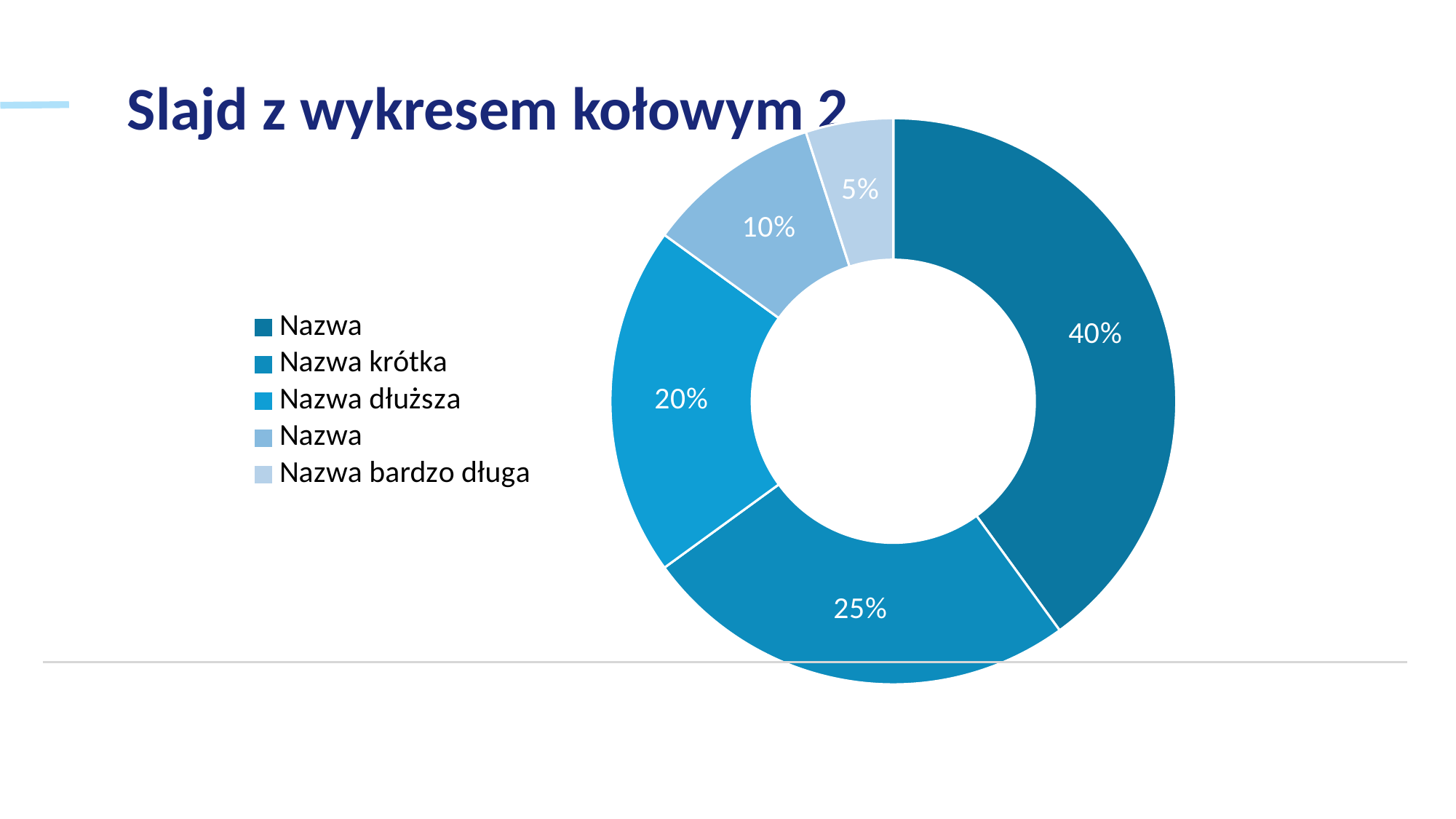
What share of the doughnut chart does the slice for Nazwa krótka represent? 25% What is the title of the slide? Slajd z wykresem kołowym 2 Which category has the smallest slice in the chart? Nazwa bardzo długa What is the largest percentage value shown on the chart? 40% What is the value shown for Nazwa dłuższa? 20% How many entries does the legend list? 5 Which is larger, the slice for Nazwa krótka or the slice for Nazwa dłuższa? Nazwa krótka What percentage is shown for Nazwa bardzo długa? 5% How many slices does the chart have? 5 What is the difference between the values for Nazwa dłuższa and Nazwa bardzo długa? 15% What is the difference between the values for Nazwa krótka and Nazwa dłuższa? 5% What kind of chart is shown on the slide? Doughnut (pie) chart